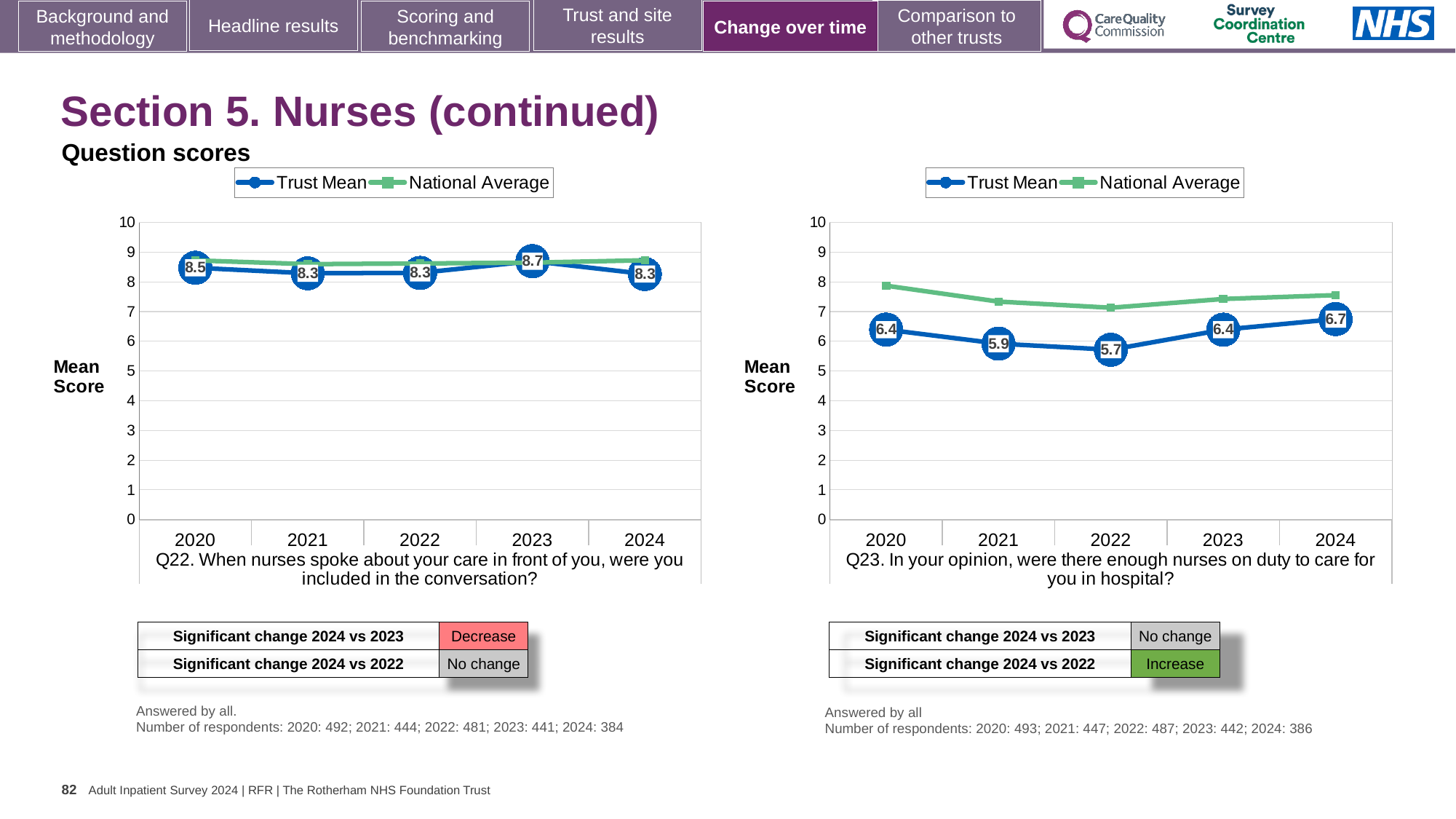
On the Q22 chart, what is the Trust Mean score for 2023? 8.7 On the Q23 chart, what is the Trust Mean score for 2024? 6.7 How many years are plotted on the Q23 chart? 5 On the Q22 chart, which year has the highest Trust Mean score? 2023 What kind of chart is used for Q23? Line chart On the Q22 chart, which is larger, the Trust Mean score for 2023 or for 2024? 2023 On the Q23 chart, which year has the lowest Trust Mean score? 2022 On the Q23 chart, is the National Average value for 2020 greater or less than 7? greater On the Q22 chart, what is the Trust Mean score for 2020? 8.5 On the Q23 chart, what is the difference between the Trust Mean scores for 2024 and 2022? 1.0 How many series does the legend of the Q22 chart list? 2 On the Q23 chart, what is the Trust Mean score for 2022? 5.7